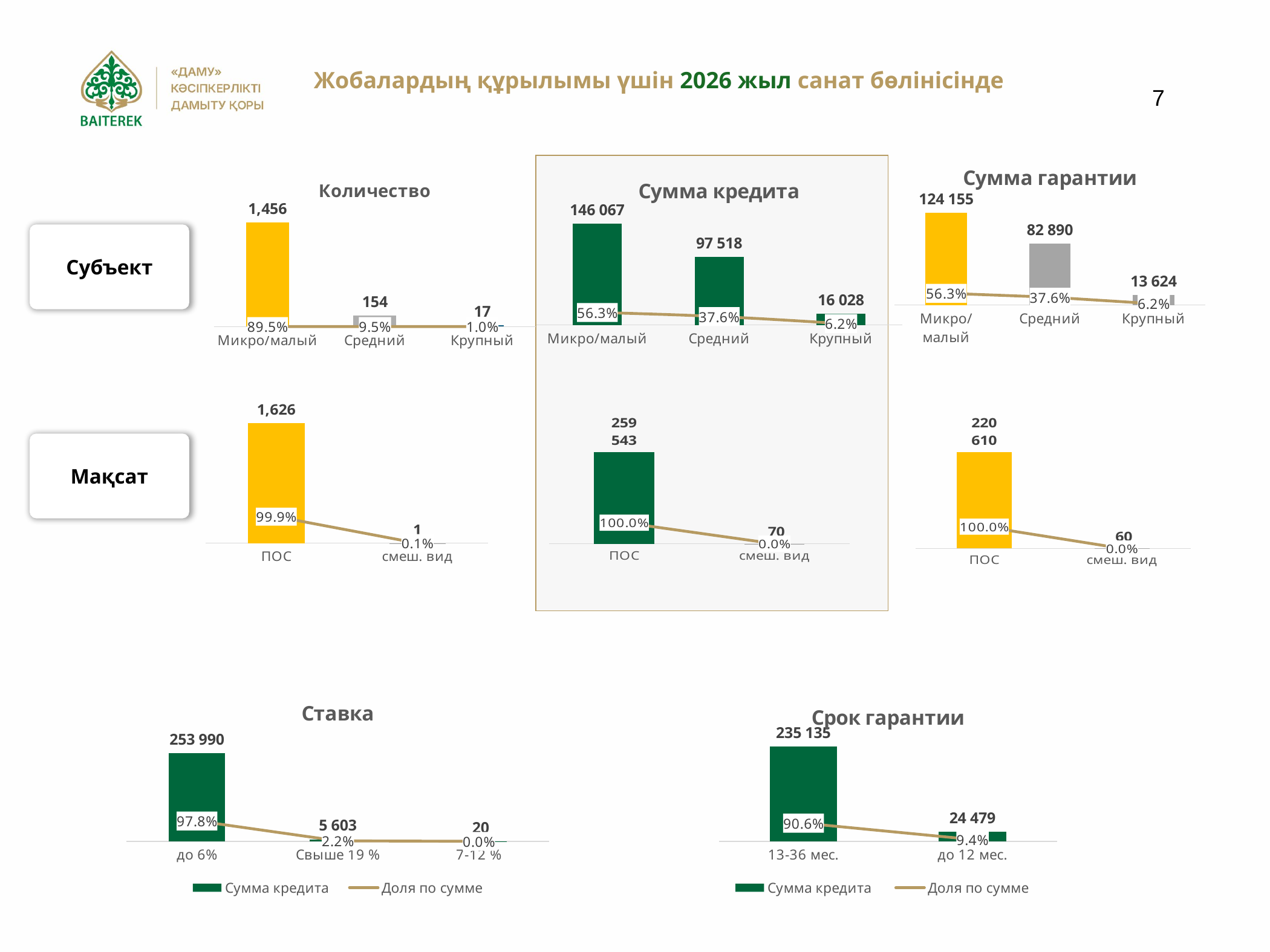
In the 'Сумма гарантии' chart in the Субъект row, which category has the lowest value? Крупный In the 'Ставка' chart, what share is shown for Свыше 19 %? 2.2% In the 'Количество' chart in the Субъект row, what is the value for Микро/малый? 1,456 In the 'Срок гарантии' chart, what is the difference between the values for 13-36 мес. and до 12 мес.? 210 656 In the 'Сумма кредита' chart in the Субъект row, what is the difference between the values for Микро/малый and Средний? 48 549 In the 'Сумма кредита' chart in the Субъект row, what is the value for Средний? 97 518 In the 'Ставка' chart, which category has the highest value? до 6% In the Мақсат row, what is the value for ПОС in the middle (Сумма кредита) chart? 259 543 How many series does the legend of the 'Срок гарантии' chart list? 2 In the 'Количество' chart in the Субъект row, how many categories are shown on the x axis? 3 In the Мақсат row, what is the value for смеш. вид in the right-hand (Сумма гарантии) chart? 60 In the 'Сумма гарантии' chart in the Субъект row, what share is shown for Средний? 37.6%